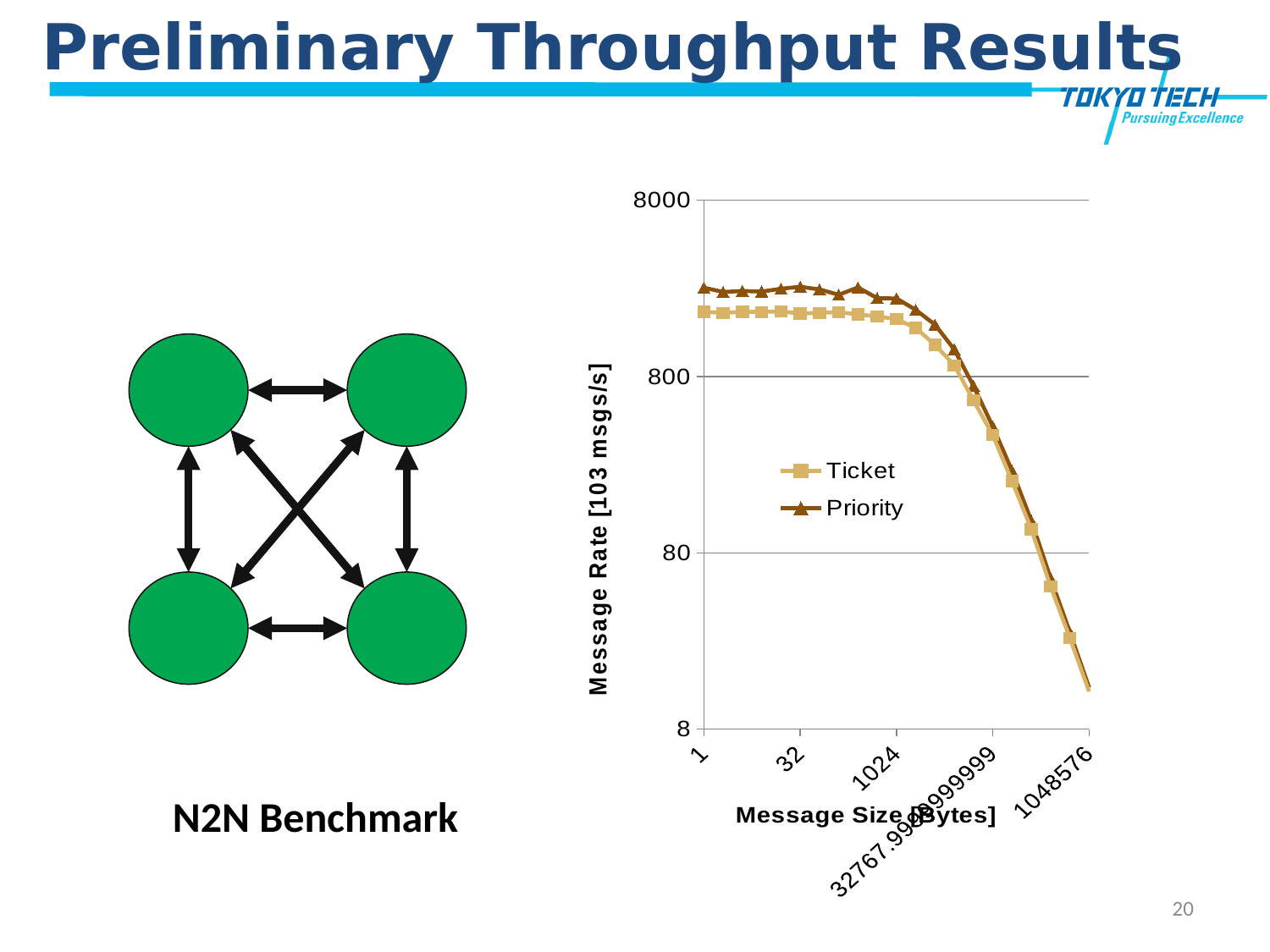
Is the Ticket message rate at message size 1 greater or less than 800? greater How many tick labels are shown on the chart's x axis? 5 What kind of chart is shown on the slide? line chart Is the Ticket message rate at message size 1048576 greater or less than 80? less How many series does the chart's legend list? 2 At message size 1, which series has the higher message rate, Ticket or Priority? Priority What are the two series named in the chart's legend? Ticket and Priority Is the Priority message rate at message size 1048576 greater or less than 80? less What is the label of the chart's y axis? Message Rate [103 msgs/s] Do the message rate values rise or fall as message size increases along the x axis? fall Which series reaches the highest message rate on the chart? Priority